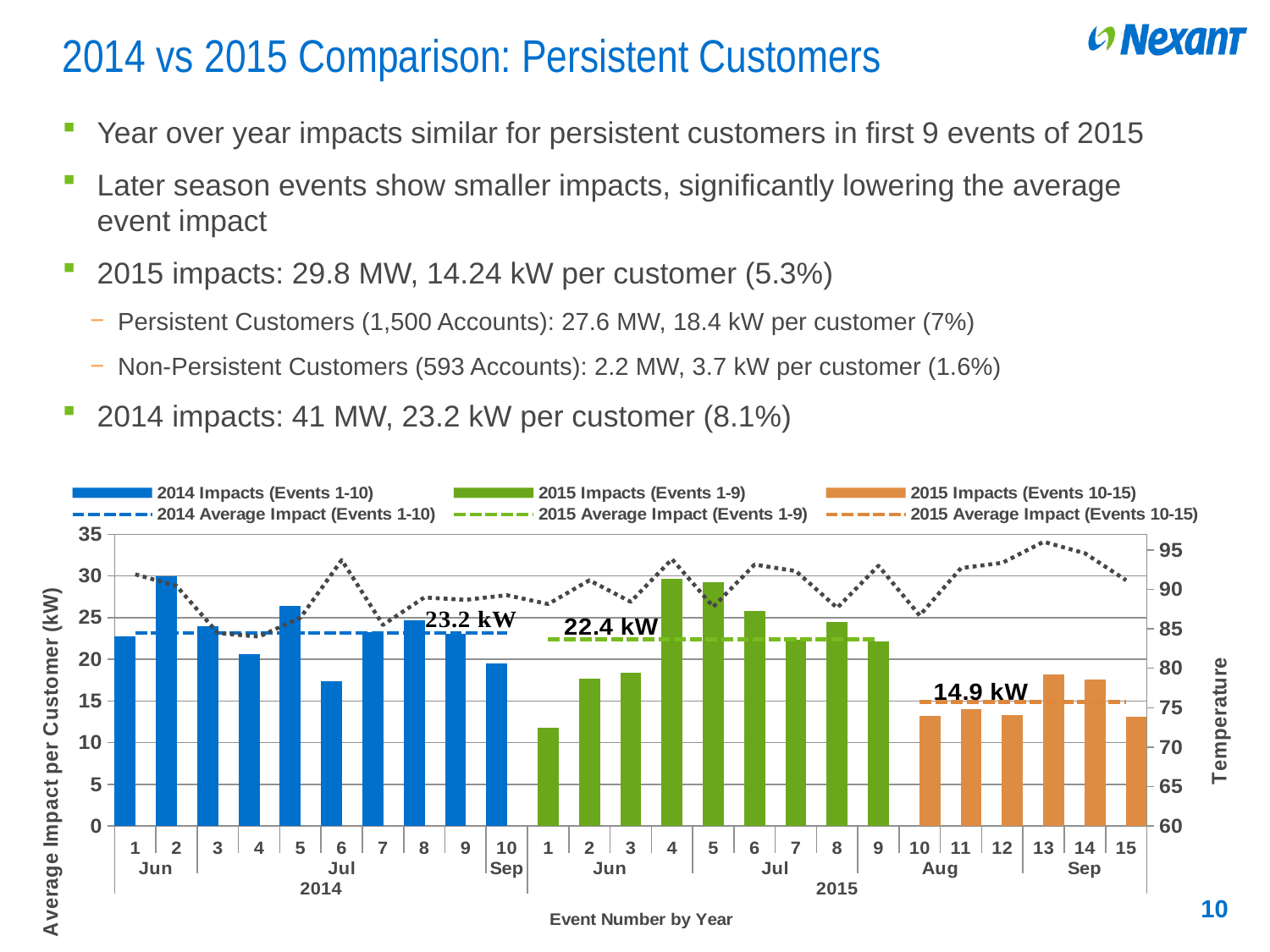
What is the 2015 average impact for events 10-15 shown on the chart? 14.9 kW What is the difference between the 2015 average impact for events 1-9 and the 2015 average impact for events 10-15? 7.5 kW Is the average impact per customer for 2014 event 6 greater or less than 20 kW? less How many 2015 events are plotted as bars on the chart? 15 What kind of chart is used to show the average impact per customer by event? Bar chart How many series does the chart legend list? 6 Is the average impact per customer for 2015 event 4 greater or less than 25 kW? greater Which of the 2015 events 1-9 has the lowest average impact per customer? Event 1 What is the 2014 average impact (events 1-10) shown as a data label on the chart? 23.2 kW Which 2014 event has the highest average impact per customer? Event 2 What is the 2015 average impact for events 1-9 shown on the chart? 22.4 kW What is the difference between the 2014 average impact (events 1-10) and the 2015 average impact for events 1-9? 0.8 kW